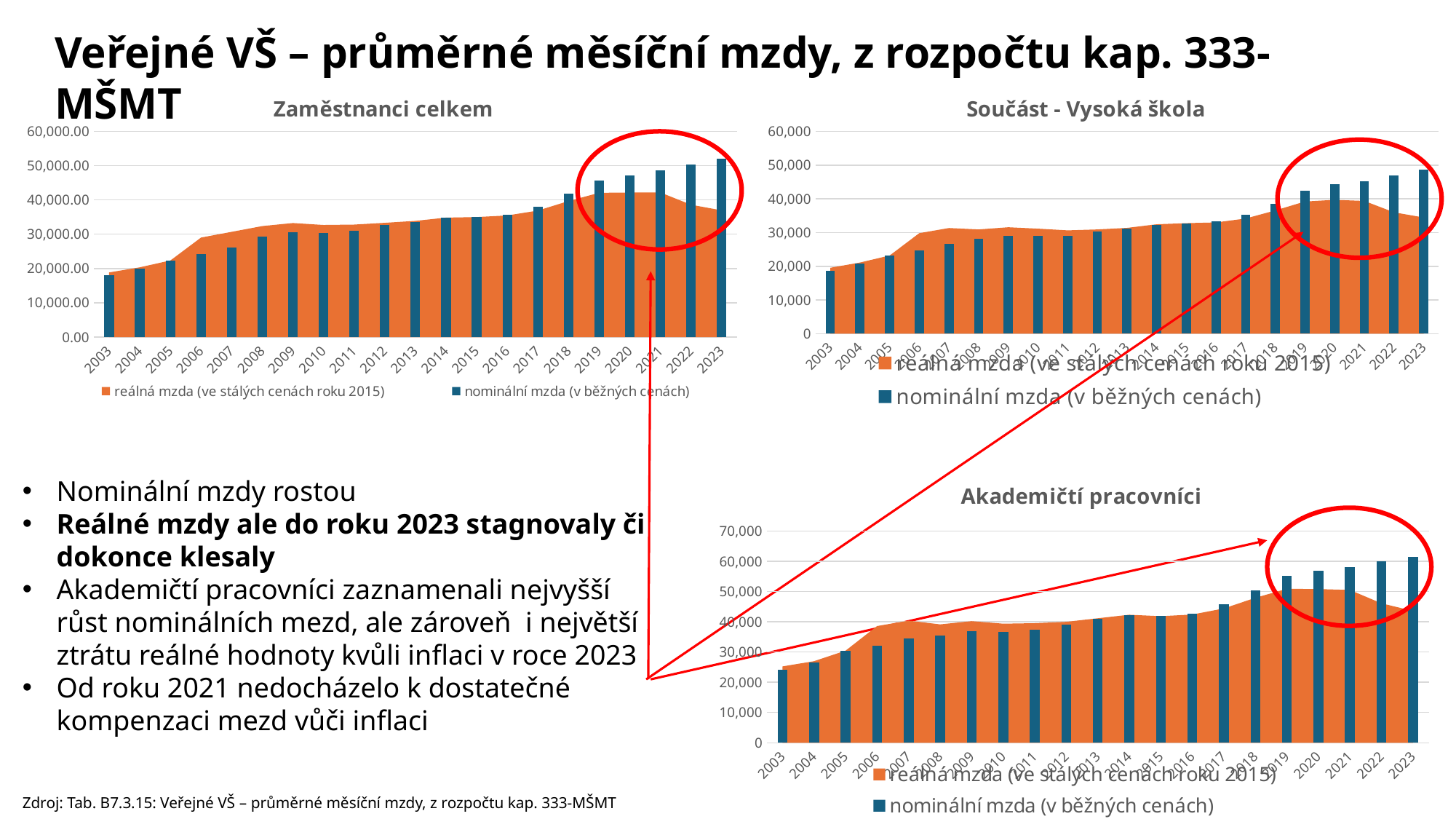
In the chart titled 'Zaměstnanci celkem', is the nominální mzda value for 2023 greater or less than 50,000? greater In the chart titled 'Akademičtí pracovníci', how many series does the legend list? 2 In the chart titled 'Akademičtí pracovníci', does the nominální mzda series rise or fall from 2003 to 2023? rise What is the title of the chart in the top-left of the slide? Zaměstnanci celkem In the chart titled 'Zaměstnanci celkem', which year has the larger nominální mzda value, 2019 or 2023? 2023 In the chart titled 'Akademičtí pracovníci', which year has the highest nominální mzda (v běžných cenách)? 2023 In the chart titled 'Akademičtí pracovníci', is the nominální mzda value for 2023 greater or less than 50,000? greater In the chart titled 'Zaměstnanci celkem', which year has the lowest nominální mzda (v běžných cenách)? 2003 In the chart titled 'Součást - Vysoká škola', which series has the larger value in 2023, reálná mzda or nominální mzda? nominální mzda In the chart titled 'Zaměstnanci celkem', how many years are shown on the x axis? 21 In the chart titled 'Akademičtí pracovníci', what kind of chart is used to plot the nominální mzda series? bar chart In the chart titled 'Součást - Vysoká škola', is the nominální mzda value for 2003 greater or less than 20,000? less